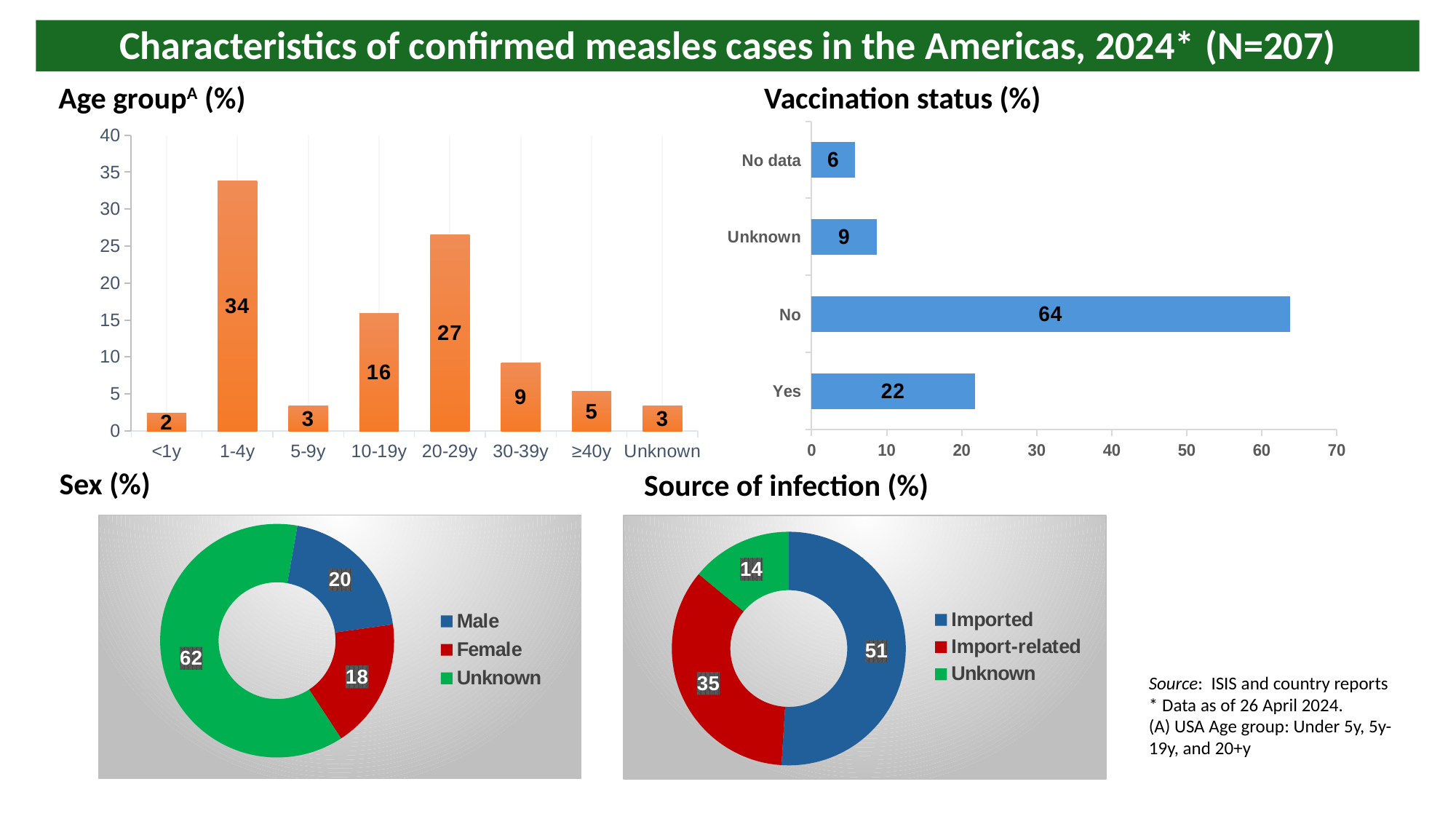
In the Vaccination status chart, what is the value for No? 64 How many entries does the legend of the Source of infection chart list? 3 In the Age group chart, what is the value for the 1-4y category? 34 How many age group categories are shown in the Age group chart? 8 In the Age group chart, which age group has the highest value? 1-4y In the Sex chart, what is the value for Female? 18 In the Source of infection chart, what is the difference between Imported and Import-related? 16 In the Age group chart, which age group has the lowest value? <1y What kind of chart is the Vaccination status chart? Bar chart In the Age group chart, what is the difference between the values for 20-29y and 10-19y? 11 In the Vaccination status chart, which category has the lowest value? No data In the Vaccination status chart, is the value for Yes larger or the value for Unknown? Yes